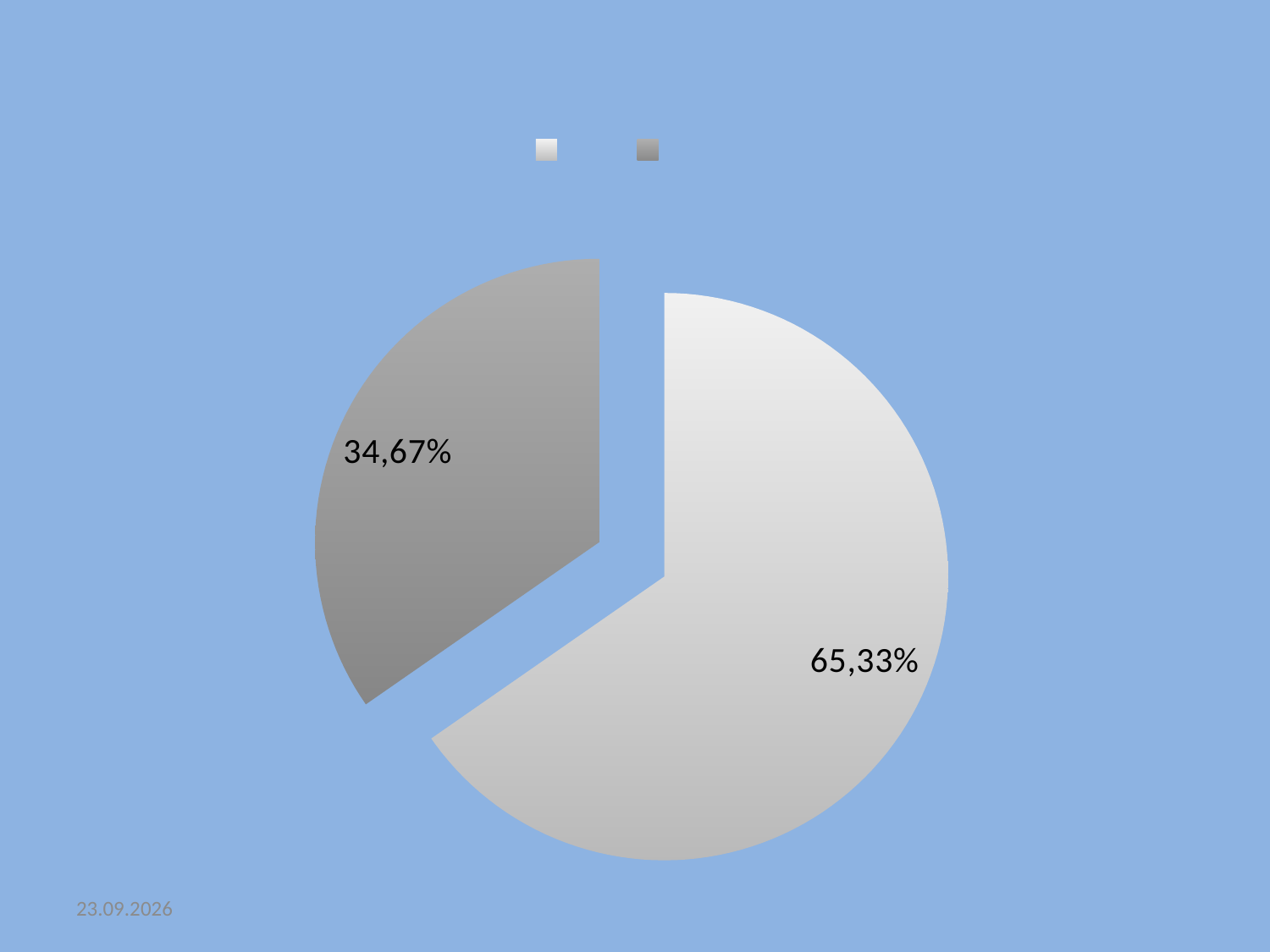
What is the difference in percentage points between the light grey slice and the dark grey slice? 30,66% Which slice of the pie chart is the largest? the light grey slice (65,33%) Which slice is larger, the light grey one or the dark grey one? the light grey one Is the share of the dark grey slice greater or less than 50%? less What percentage is shown on the dark grey slice of the pie chart? 34,67% What percentage is shown on the light grey slice of the pie chart? 65,33% What share of the pie does the light grey slice represent? 65,33% How many slices does the pie chart have? 2 How many entries does the legend of the pie chart list? 2 What kind of chart is shown on the slide? pie chart Which slice of the pie chart is the smallest? the dark grey slice (34,67%)